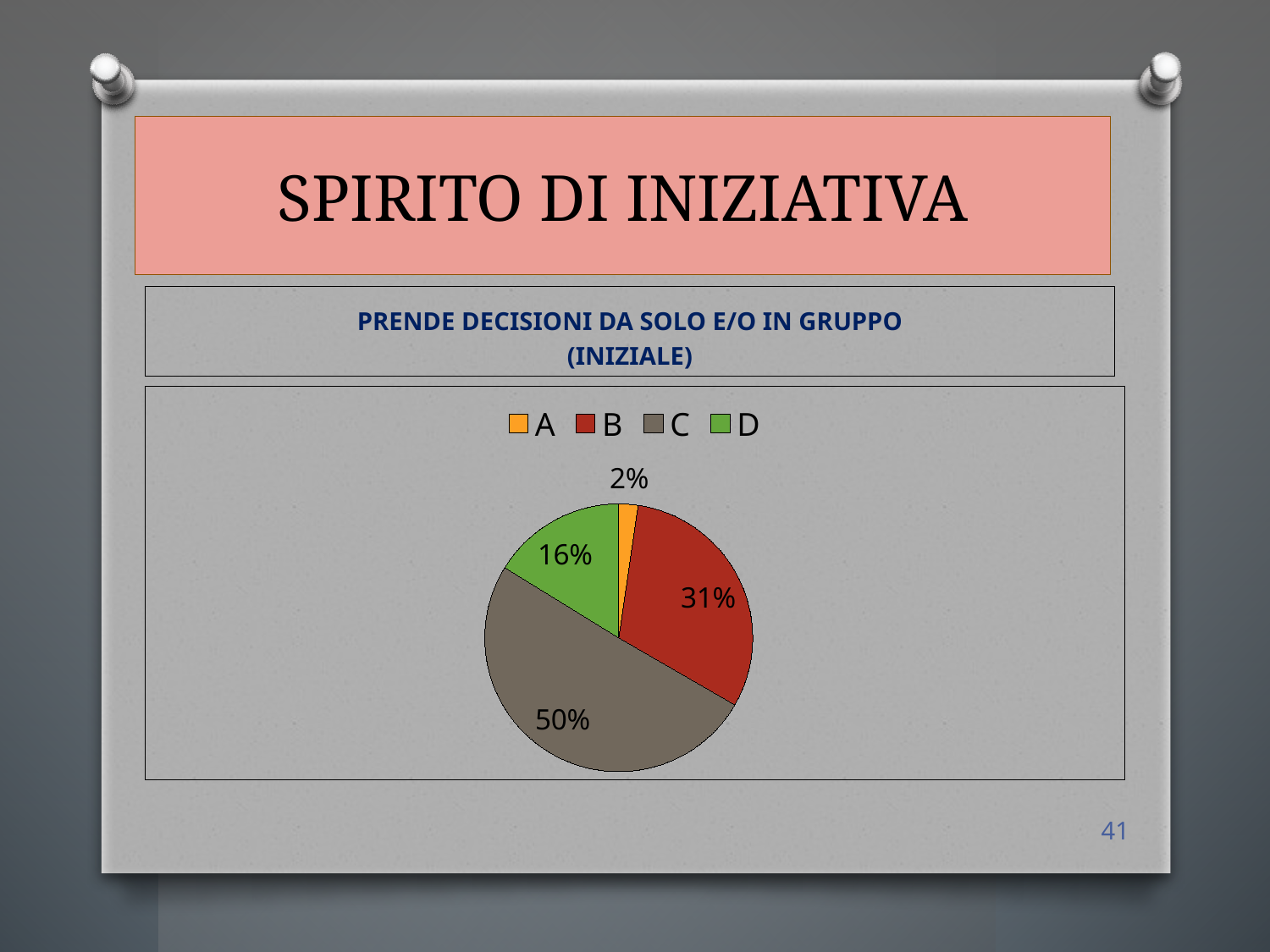
What percentage does slice B represent in the pie chart? 31% What is the title of the chart on the slide? PRENDE DECISIONI DA SOLO E/O IN GRUPPO (INIZIALE) Which category has the largest slice in the pie chart? C What type of chart is shown on the slide? Pie chart What percentage does slice D represent in the pie chart? 16% Which category has the smallest slice in the pie chart? A How many categories does the pie chart show? 4 What percentage does slice A represent in the pie chart? 2% Which is larger, slice B or slice D? B What colour is the slice for category D in the pie chart? Green What is the difference in percentage points between slice C and slice B? 19 What percentage does slice C represent in the pie chart? 50%